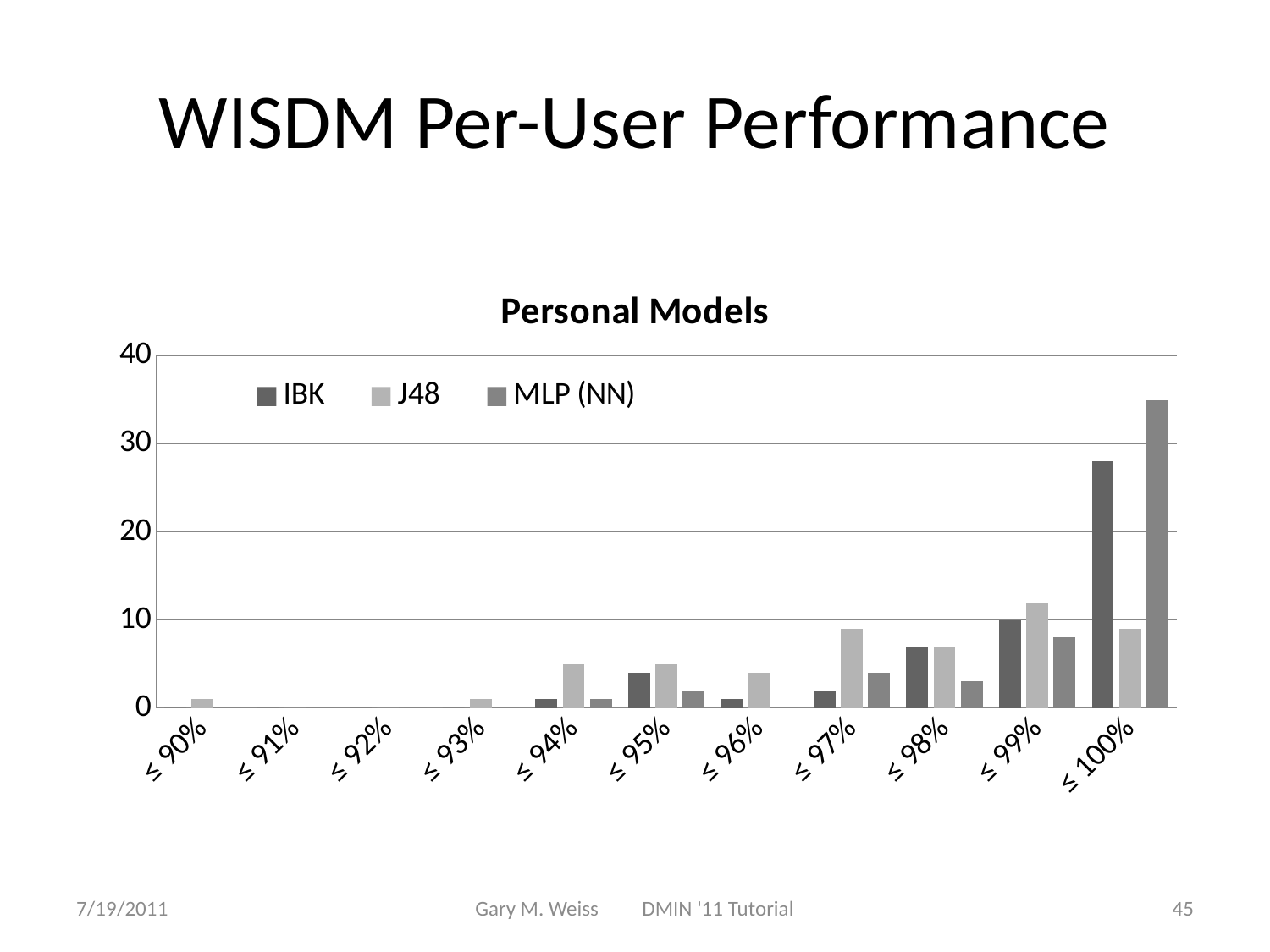
Is the MLP (NN) value for ≤ 100% greater or less than 30? greater Which series are listed in the legend? IBK, J48, MLP (NN) How many series does the legend list? 3 What is the title of the chart? Personal Models At ≤ 100%, which series has the larger value, IBK or MLP (NN)? MLP (NN) How many categories are shown along the x axis? 11 Do the bar values generally rise or fall moving from ≤ 90% to ≤ 100% along the x axis? rise What kind of chart is shown on the slide? bar chart Is the J48 value for ≤ 97% greater or less than 10? less At ≤ 99%, which series has the larger value, J48 or MLP (NN)? J48 For which category is the MLP (NN) bar the tallest? ≤ 100% Is the IBK value for ≤ 100% greater or less than 20? greater